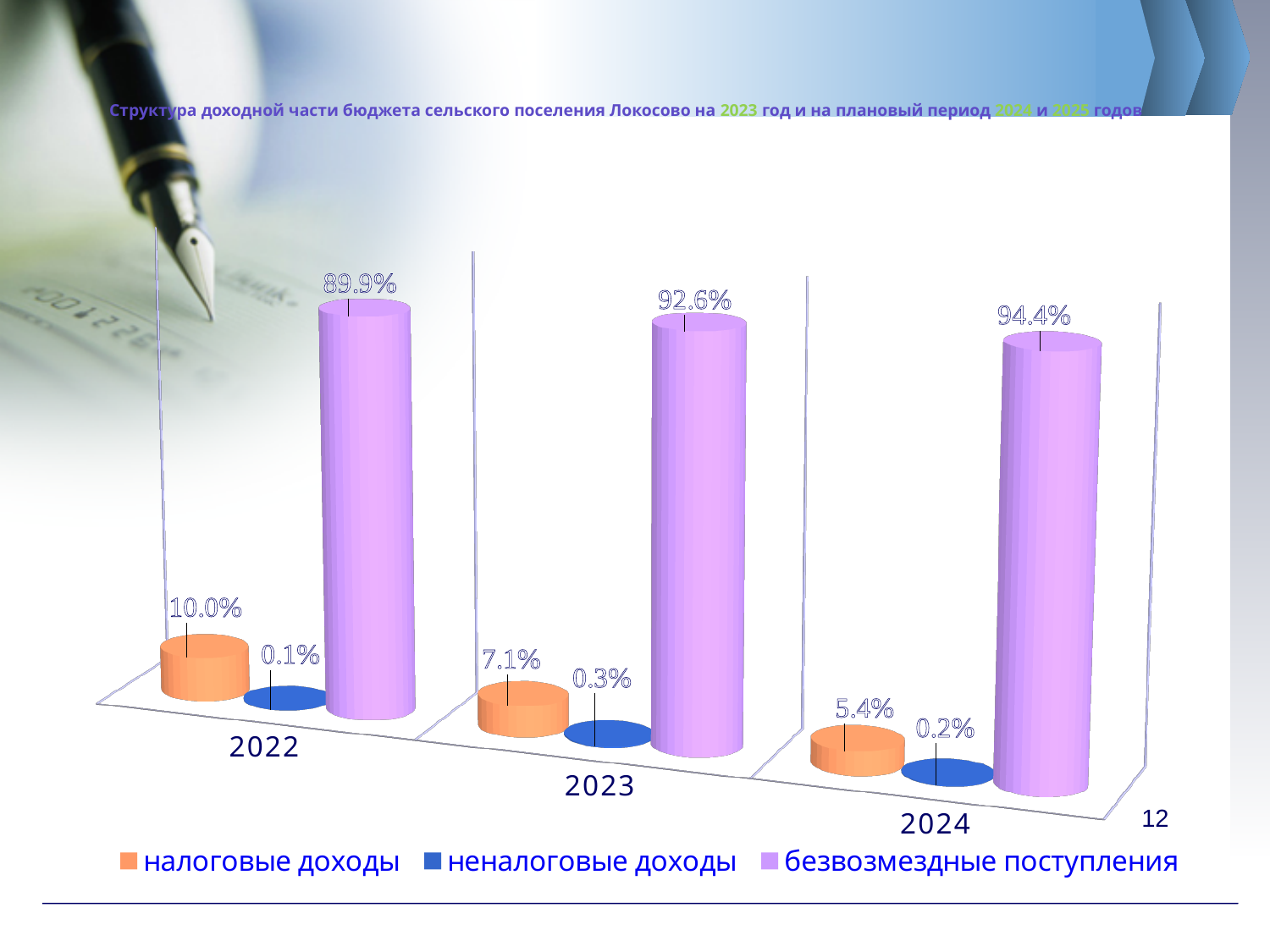
What is the value for неналоговые доходы in 2024? 0.2% What kind of chart is shown on the slide? bar chart In which year is налоговые доходы lowest? 2024 In which year is безвозмездные поступления highest? 2024 How many years are shown on the x axis? 3 What is the difference between безвозмездные поступления in 2024 and in 2022? 4.5% What is the value for налоговые доходы in 2022? 10.0% Which is larger: налоговые доходы in 2022 or налоговые доходы in 2023? налоговые доходы in 2022 What is the value for налоговые доходы in 2024? 5.4% How many series does the legend list? 3 What is the value for безвозмездные поступления in 2023? 92.6% Do the values for налоговые доходы rise or fall from 2022 to 2024? fall